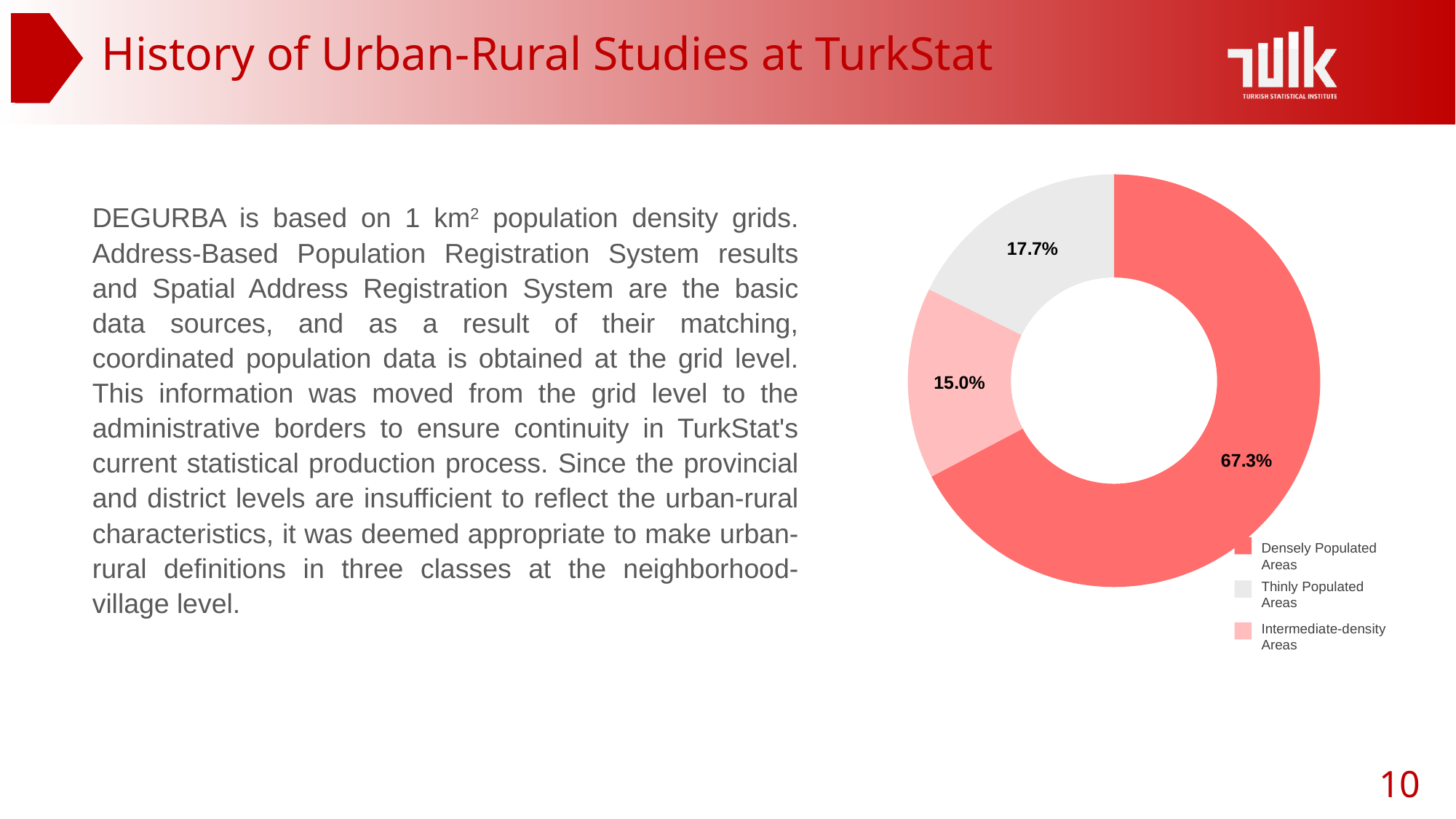
Which is larger: the share for Thinly Populated Areas or Intermediate-density Areas? Thinly Populated Areas What is the difference in percentage points between Densely Populated Areas and Thinly Populated Areas? 49.6 What share of the doughnut chart is Intermediate-density Areas? 15.0% What share of the doughnut chart is Densely Populated Areas? 67.3% Which legend entry is listed first in the chart? Densely Populated Areas What share of the doughnut chart is Thinly Populated Areas? 17.7% What kind of chart is shown on the slide? Doughnut (pie) chart How many categories does the doughnut chart show? 3 Which category has the smallest share in the doughnut chart? Intermediate-density Areas What is the difference in percentage points between Thinly Populated Areas and Intermediate-density Areas? 2.7 What colour is the Thinly Populated Areas slice in the chart? Light grey Which category has the largest share in the doughnut chart? Densely Populated Areas